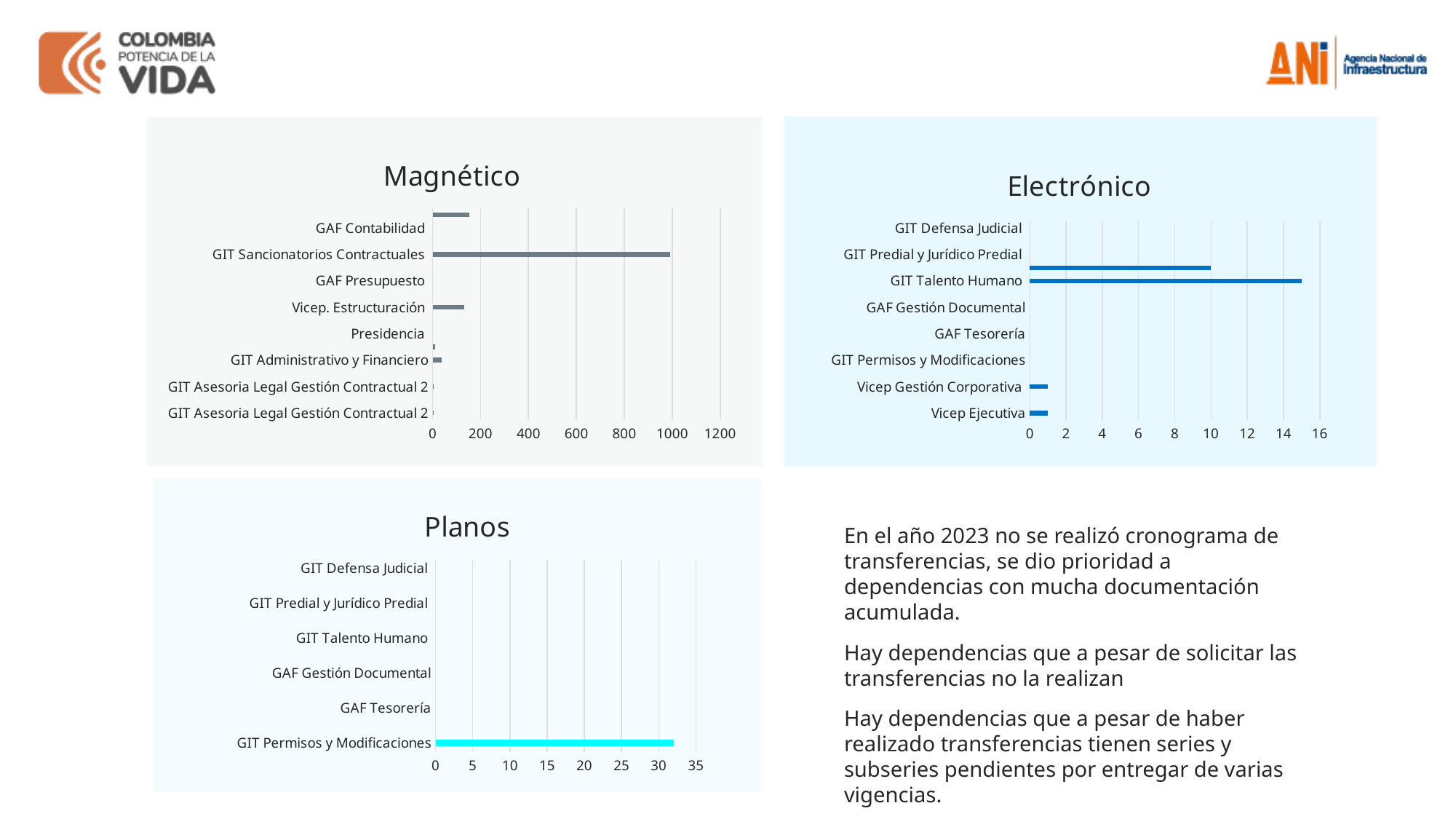
In the Electrónico chart, which category has the highest value? GIT Talento Humano In the Magnético chart, which category has the highest value? GIT Sancionatorios Contractuales In the Electrónico chart, is the value for GIT Talento Humano greater or less than 12? greater In the Planos chart, is the value for GIT Permisos y Modificaciones greater or less than 30? greater In the Magnético chart, is the value for GIT Sancionatorios Contractuales greater or less than 800? greater How many categories are listed on the Planos chart? 6 In the Magnético chart, which is larger: GIT Sancionatorios Contractuales or GAF Contabilidad? GIT Sancionatorios Contractuales In the Electrónico chart, which is larger: GIT Talento Humano or GIT Predial y Jurídico Predial? GIT Talento Humano What kind of chart is the Magnético chart? bar chart How many categories are listed on the Electrónico chart? 8 In the Electrónico chart, what is the value for GIT Predial y Jurídico Predial? 10 How many categories are listed on the Magnético chart? 8